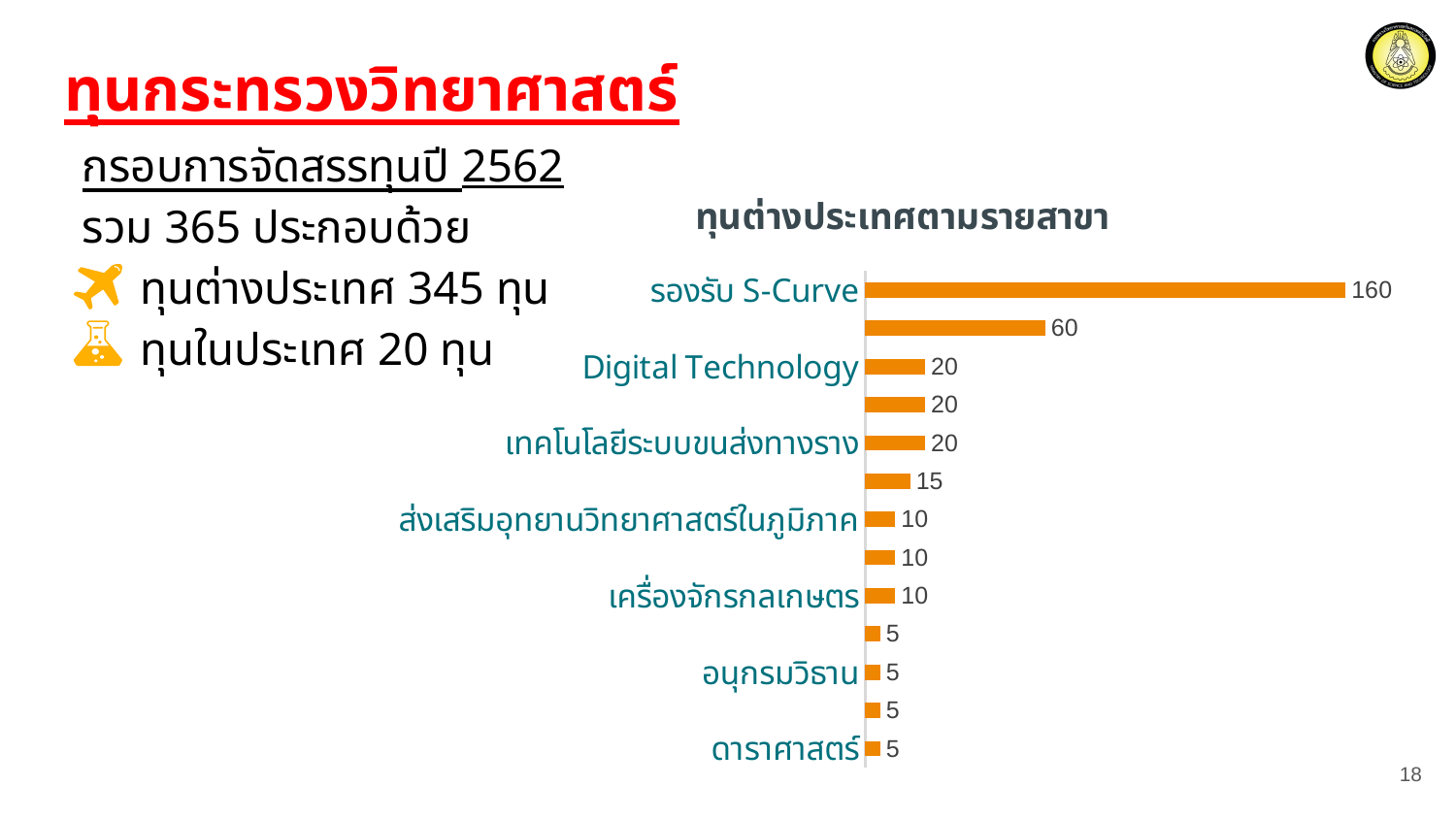
What is the value for Digital Technology? 20 What is the value for รองรับ S-Curve? 160 Which is larger, the value for เครื่องจักรกลเกษตร or the value for ดาราศาสตร์? เครื่องจักรกลเกษตร What is the value for ส่งเสริมอุทยานวิทยาศาสตร์ในภูมิภาค? 10 What is the title of the chart? ทุนต่างประเทศตามรายสาขา What is the value for ดาราศาสตร์? 5 What type of chart is shown on the slide? bar chart Which category has the highest value? รองรับ S-Curve What is the difference between the values for รองรับ S-Curve and Digital Technology? 140 What is the value for เครื่องจักรกลเกษตร? 10 What is the value for อนุกรมวิธาน? 5 What is the value for เทคโนโลยีระบบขนส่งทางราง? 20